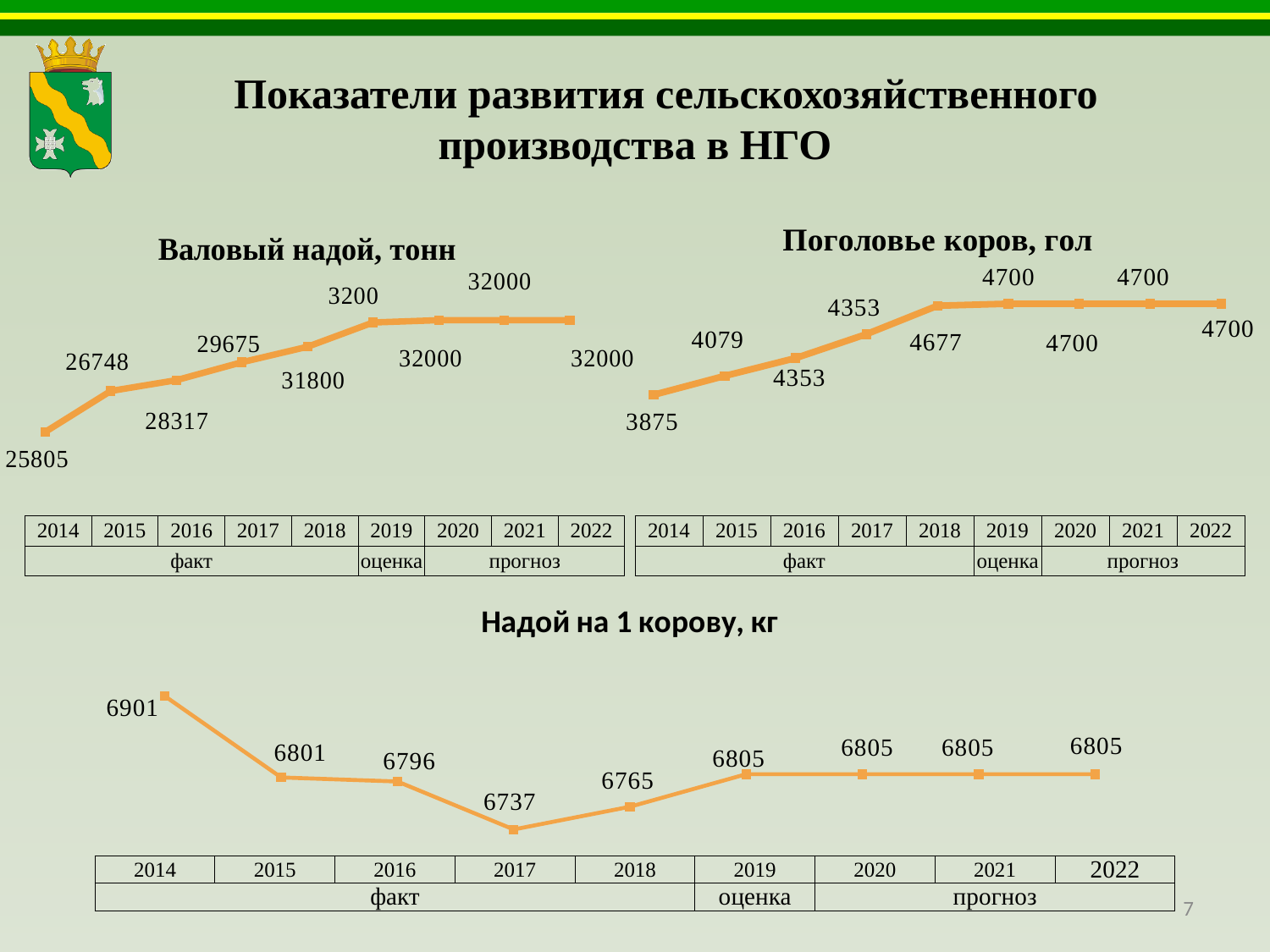
In the chart 'Надой на 1 корову, кг', what is the value for 2017? 6737 In the chart 'Валовый надой, тонн', what is the difference between the values for 2016 and 2015? 1569 In the chart 'Поголовье коров, гол', what is the difference between the values for 2019 and 2018? 23 In the chart 'Надой на 1 корову, кг', which year has the highest value? 2014 In the chart 'Валовый надой, тонн', what is the value for 2018? 31800 In the chart 'Надой на 1 корову, кг', which is larger, the value for 2015 or the value for 2018? 2015 In the chart 'Валовый надой, тонн', which year has the lowest value? 2014 In the chart 'Поголовье коров, гол', which year has the lowest value? 2014 In the chart 'Валовый надой, тонн', what is the value for 2014? 25805 How many years are plotted in the chart 'Надой на 1 корову, кг'? 9 In the chart 'Поголовье коров, гол', what is the value for 2018? 4677 In the chart 'Поголовье коров, гол', what is the value for 2015? 4079